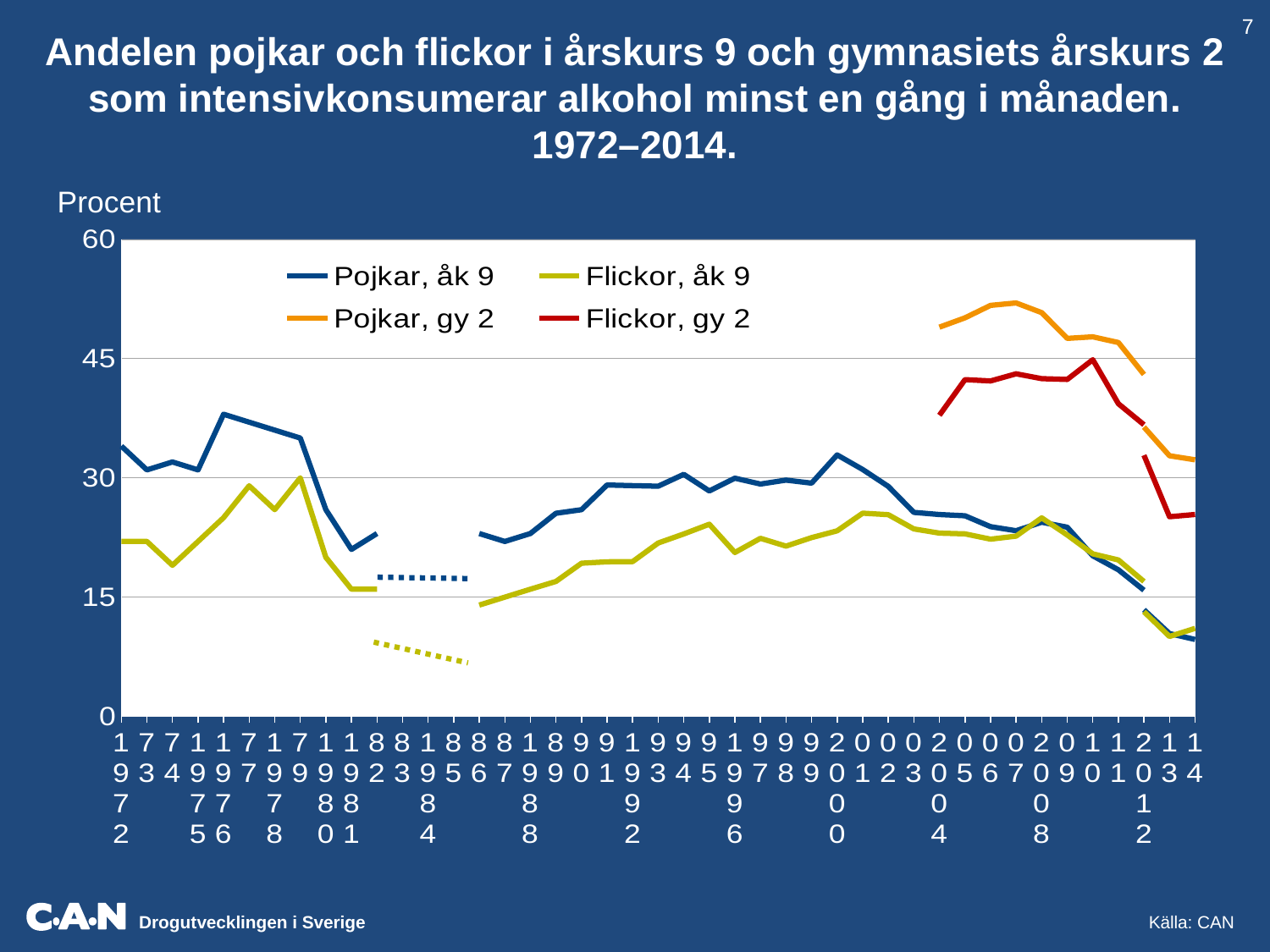
Is the value for Pojkar, åk 9 in 2014 greater or less than 15? less Which series are listed in the legend? Pojkar, åk 9; Flickor, åk 9; Pojkar, gy 2; Flickor, gy 2 What kind of chart is shown on the slide? line chart How many series does the legend list? 4 What is the label on the vertical axis? Procent Is the value for Pojkar, gy 2 in 2014 greater or less than 30? greater Is the value for Pojkar, åk 9 in 1972 greater or less than 30? greater Does the Pojkar, gy 2 series rise or fall from 2008 to 2014? fall In 1972, which is higher: Pojkar, åk 9 or Flickor, åk 9? Pojkar, åk 9 Which series reaches the highest value on the chart? Pojkar, gy 2